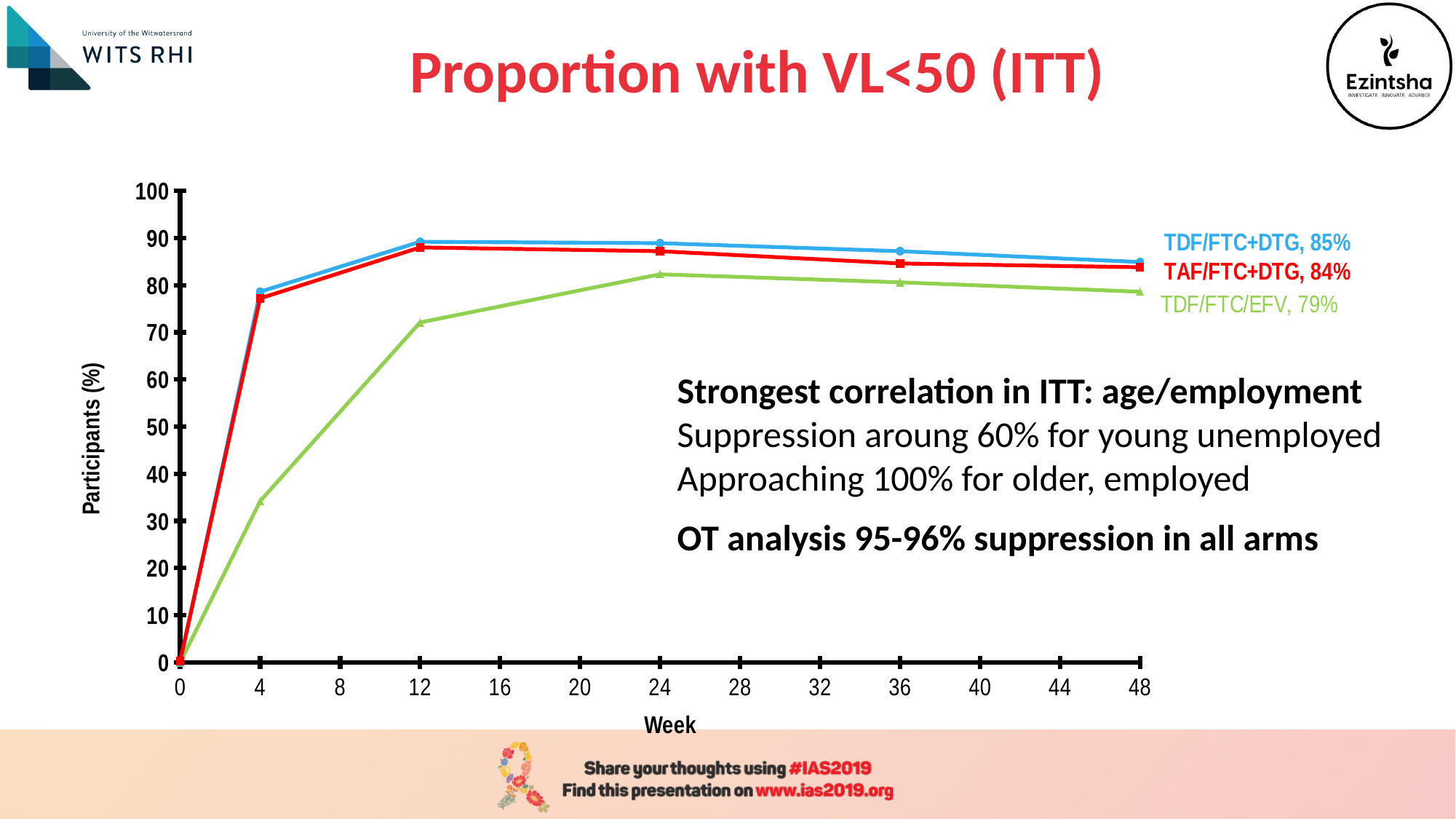
What type of chart is shown on the slide? line chart Is the value for TAF/FTC+DTG at week 24 greater or less than 80? greater What is the value for TDF/FTC/EFV at week 48? 79% Which series has the lowest value at week 48? TDF/FTC/EFV What is the value for TAF/FTC+DTG at week 48? 84% How many series are plotted on the chart? 3 Which series has the highest value at week 48? TDF/FTC+DTG Between week 0 and week 12, does the TDF/FTC/EFV line rise or fall? rise What is the value for TDF/FTC+DTG at week 48? 85% What is the difference between the week 48 values for TDF/FTC+DTG and TDF/FTC/EFV? 6 percentage points At week 12, which series is higher: TDF/FTC+DTG or TDF/FTC/EFV? TDF/FTC+DTG Is the value for TDF/FTC/EFV at week 4 greater or less than 40? less